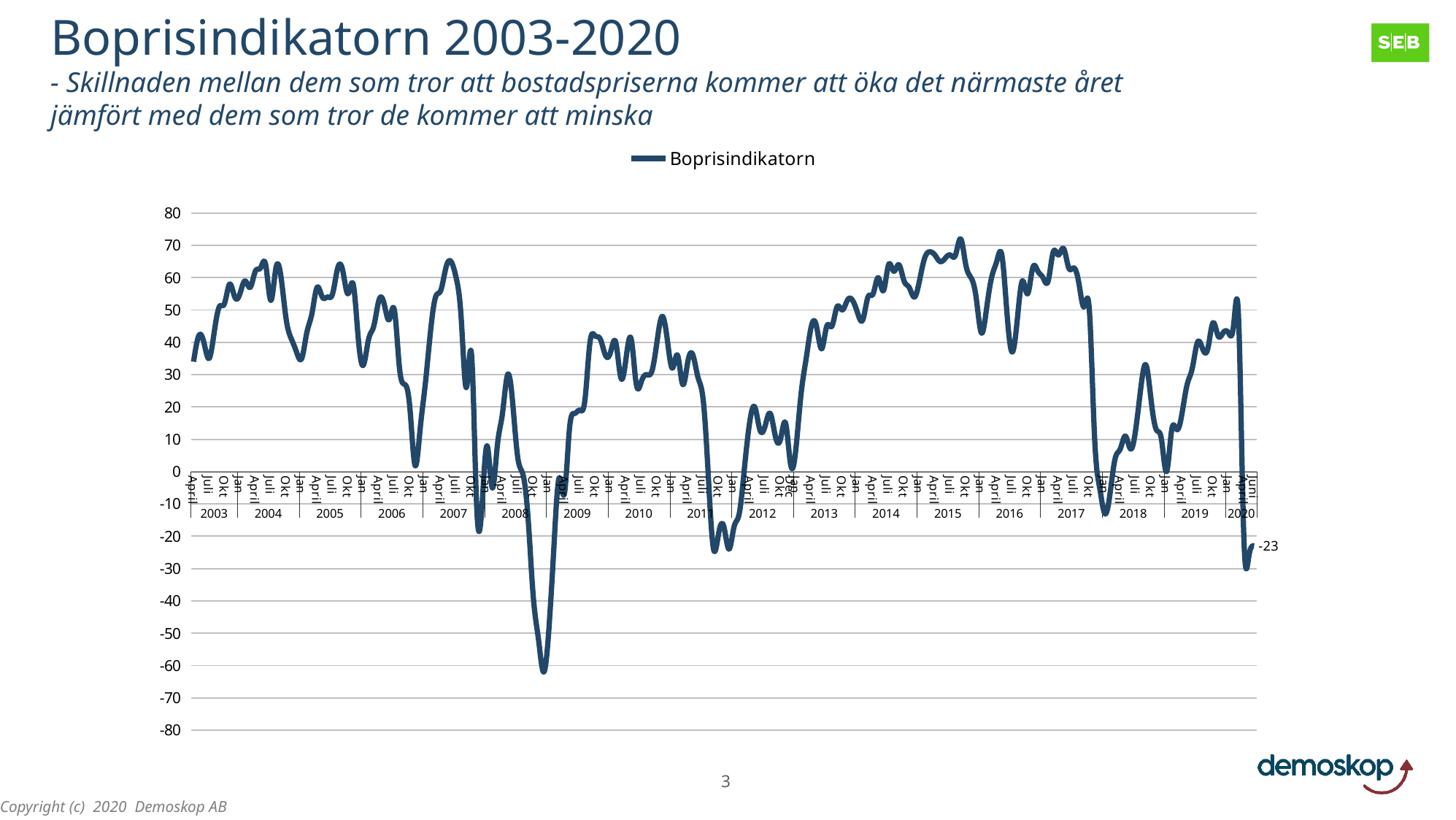
Is the value at Jan 2018 greater or less than 0? less Is the lowest point of the line, around the start of 2009, greater or less than -50? less What is the highest value shown on the vertical axis? 80 What kind of chart is shown on the slide? line chart How many series does the legend list? 1 Is the value at Jan 2012 greater or less than -10? less What is the value of Boprisindikatorn at the last point (Juni 2020), as printed on the chart? -23 What is the name of the series shown in the legend? Boprisindikatorn Which year has the higher peak value: 2004 or 2015? 2015